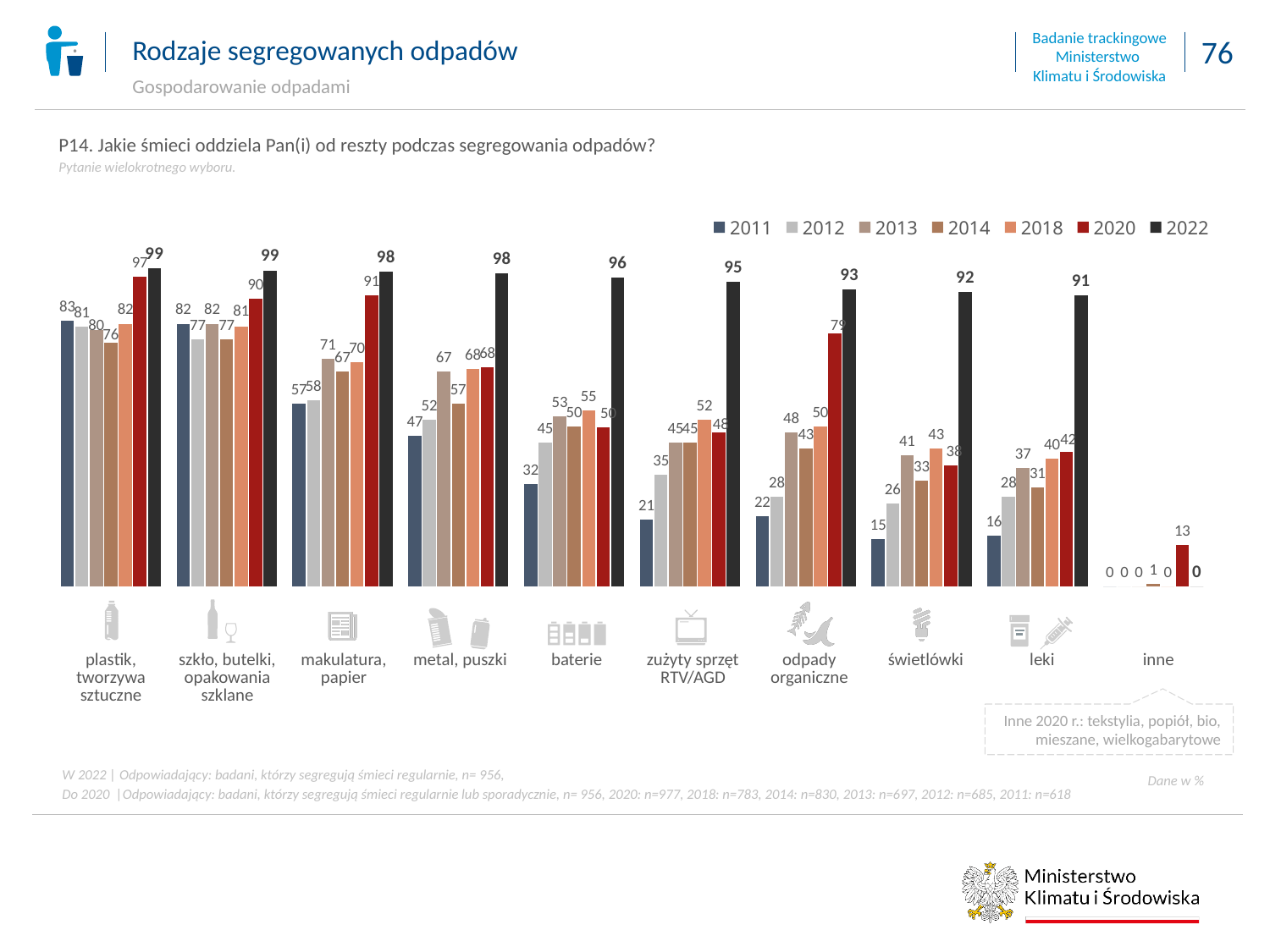
What is the difference between the 2022 values for plastik, tworzywa sztuczne and leki? 8 Which category has the lowest 2022 value (excluding inne)? leki What is the 2020 value for odpady organiczne? 79 What is the 2020 value for inne? 13 Which category has the highest 2011 value? plastik, tworzywa sztuczne Which is larger for leki: the 2018 value or the 2020 value? 2020 How many series does the legend list? 7 How many waste categories are shown on the x axis? 10 What is the 2022 value for plastik, tworzywa sztuczne? 99 What is the 2011 value for świetlówki? 15 What is the difference between the 2022 and 2020 values for baterie? 46 What kind of chart is shown on the slide? bar chart